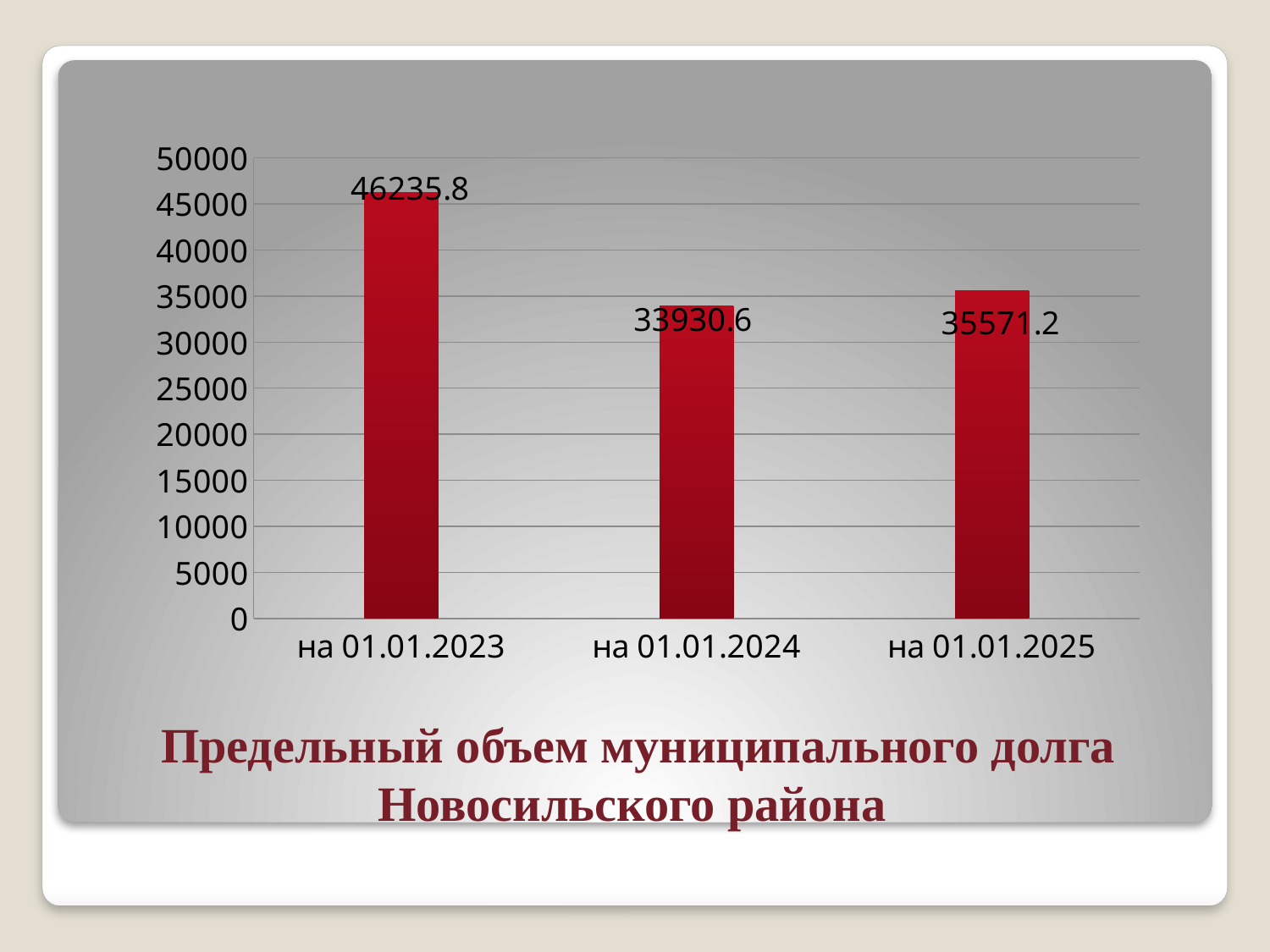
Which is larger, the value for на 01.01.2024 or на 01.01.2025? на 01.01.2025 What kind of chart is shown on the slide? bar chart How many bars are shown in the chart? 3 Is the value for на 01.01.2023 greater or less than 45000? greater What is the difference between the values for на 01.01.2023 and на 01.01.2024? 12305.2 What is the difference between the values for на 01.01.2025 and на 01.01.2024? 1640.6 What is the value for на 01.01.2024? 33930.6 Which date has the highest value? на 01.01.2023 What is the title of the chart? Предельный объем муниципального долга Новосильского района What is the value for на 01.01.2023? 46235.8 What is the value for на 01.01.2025? 35571.2 Which date has the lowest value? на 01.01.2024